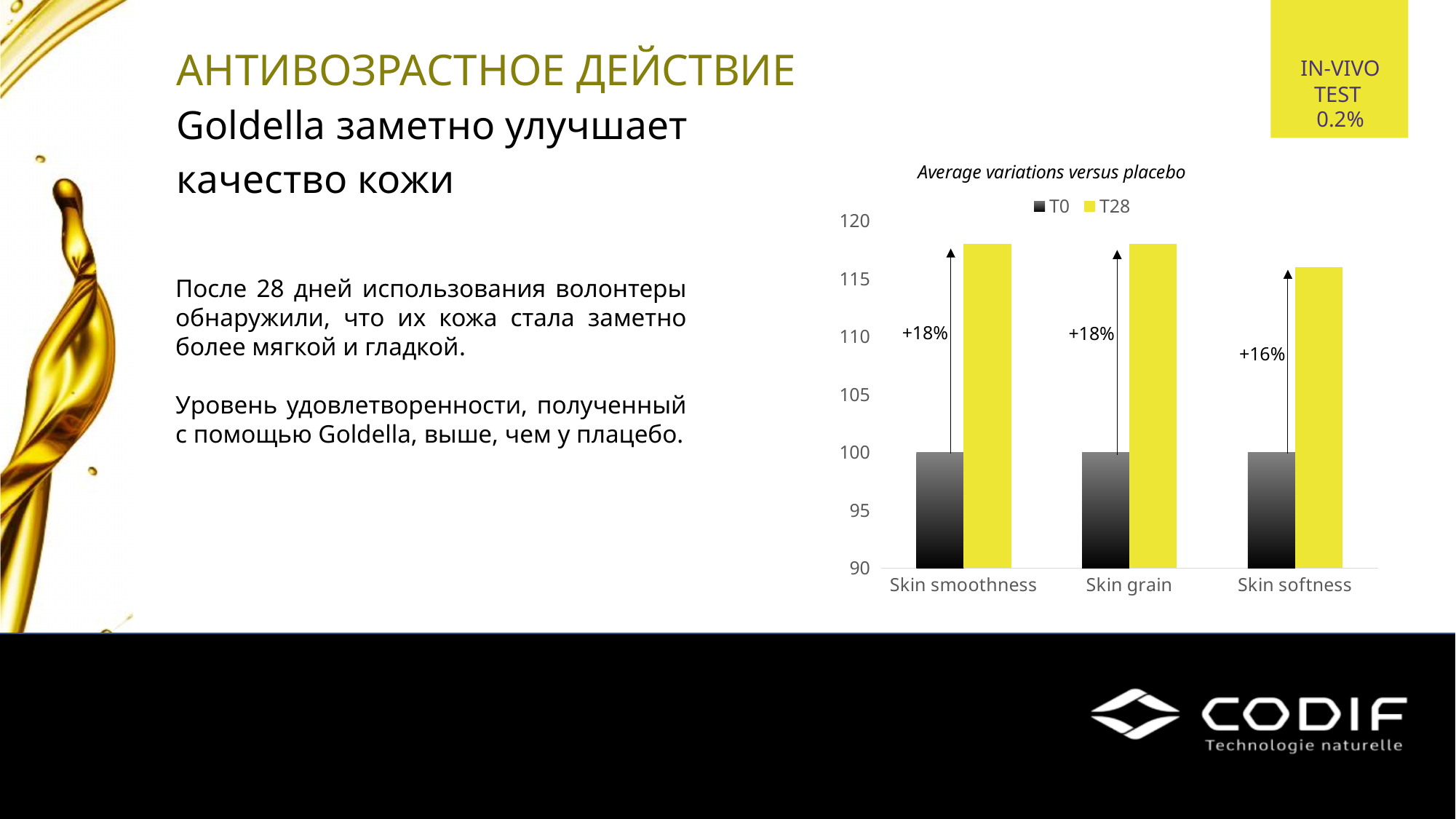
How many categories are shown on the x axis of the chart? 3 What kind of chart is shown on the slide? bar chart How many series does the chart legend list? 2 Which has the larger T28 value, Skin smoothness or Skin softness? Skin smoothness Is the T28 value for Skin smoothness greater or less than 115? greater Is the T28 value for Skin softness greater or less than 110? greater What is the T0 value for Skin smoothness? 100 What percentage change is labelled for Skin softness? +16% What is the title of the chart? Average variations versus placebo Which category shows the smallest labelled percentage increase? Skin softness What percentage change is labelled for Skin grain? +18% Which series are listed in the chart legend? T0 and T28